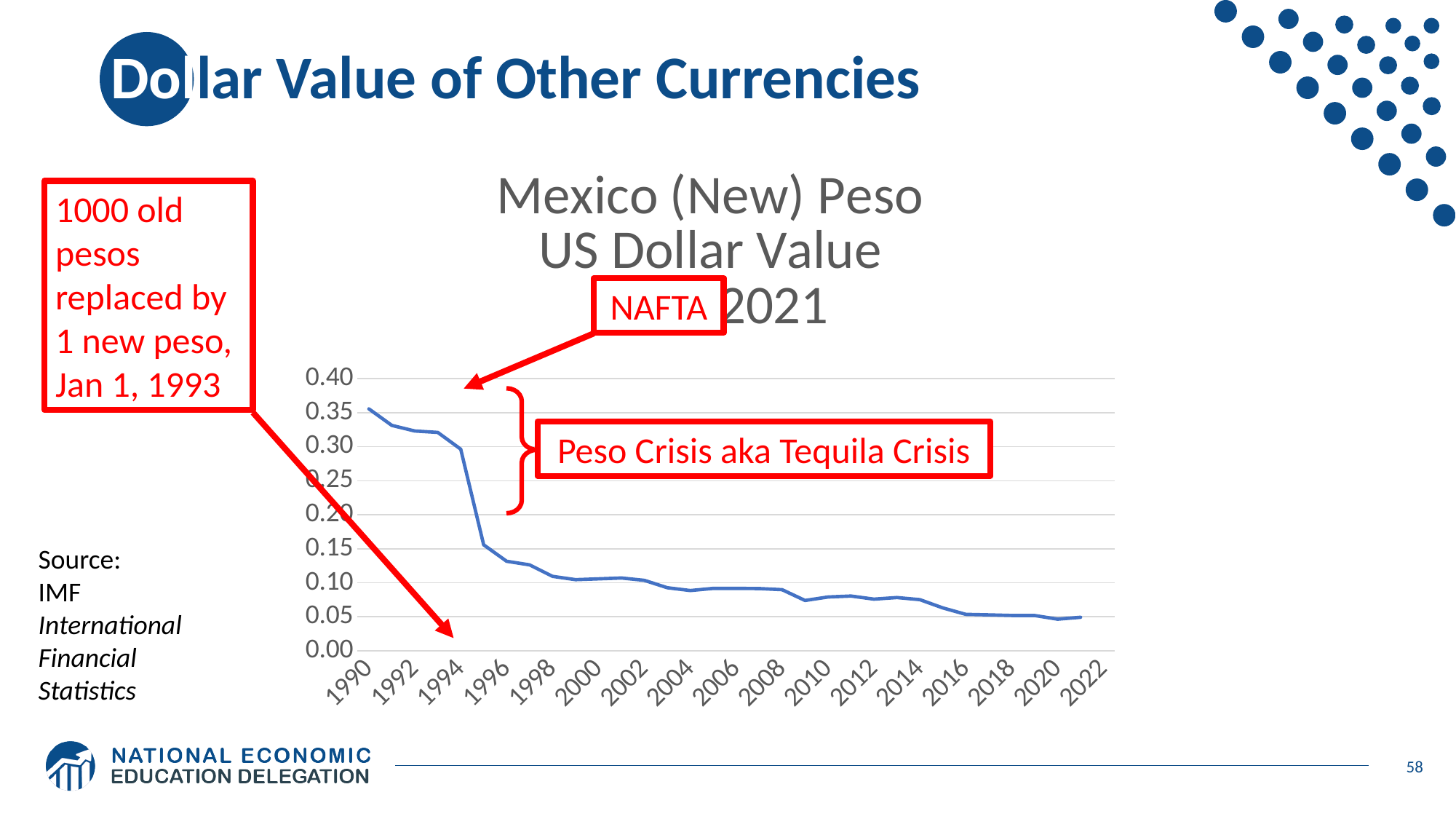
In which year is the US dollar value of the peso highest? 1990 What kind of chart is shown on the slide? line chart Which year has a higher US dollar value of the peso, 1992 or 2000? 1992 Is the value for 1990 greater or less than 0.30? greater Is the value for 2020 greater or less than 0.10? less Is the value for 1996 greater or less than 0.20? less What event does the annotation label the sharp drop in the mid-1990s as? Peso Crisis aka Tequila Crisis What is the title of the chart? Mexico (New) Peso US Dollar Value 1990-2021 How many year labels are shown on the x axis? 17 Overall, does the US dollar value of the Mexican peso rise or fall from 1990 to 2021? fall